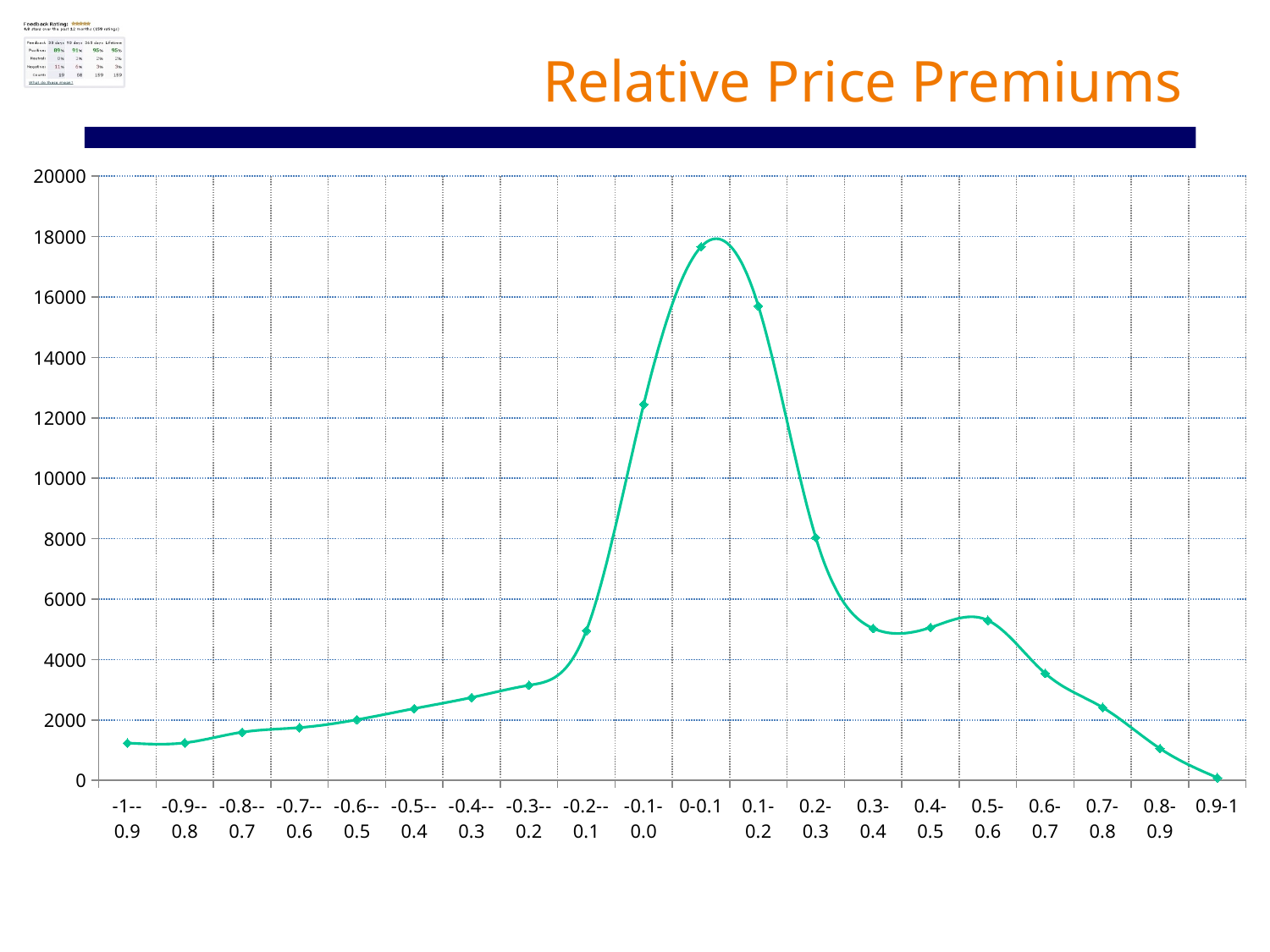
Is the value for -0.2--0.1 greater or less than 6000? less Is the value for 0-0.1 greater or less than 16000? greater Is the value for 0.1-0.2 greater or less than 14000? greater What is the title of the chart? Relative Price Premiums What kind of chart is shown on the slide? line chart Do the values generally rise or fall from 0-0.1 to 0.9-1? fall Which is larger, the value for 0.2-0.3 or the value for 0.5-0.6? 0.2-0.3 Which category has the highest value? 0-0.1 How many categories are shown on the x axis? 20 Which is larger, the value for 0-0.1 or the value for 0.1-0.2? 0-0.1 Which category has the lowest value? 0.9-1